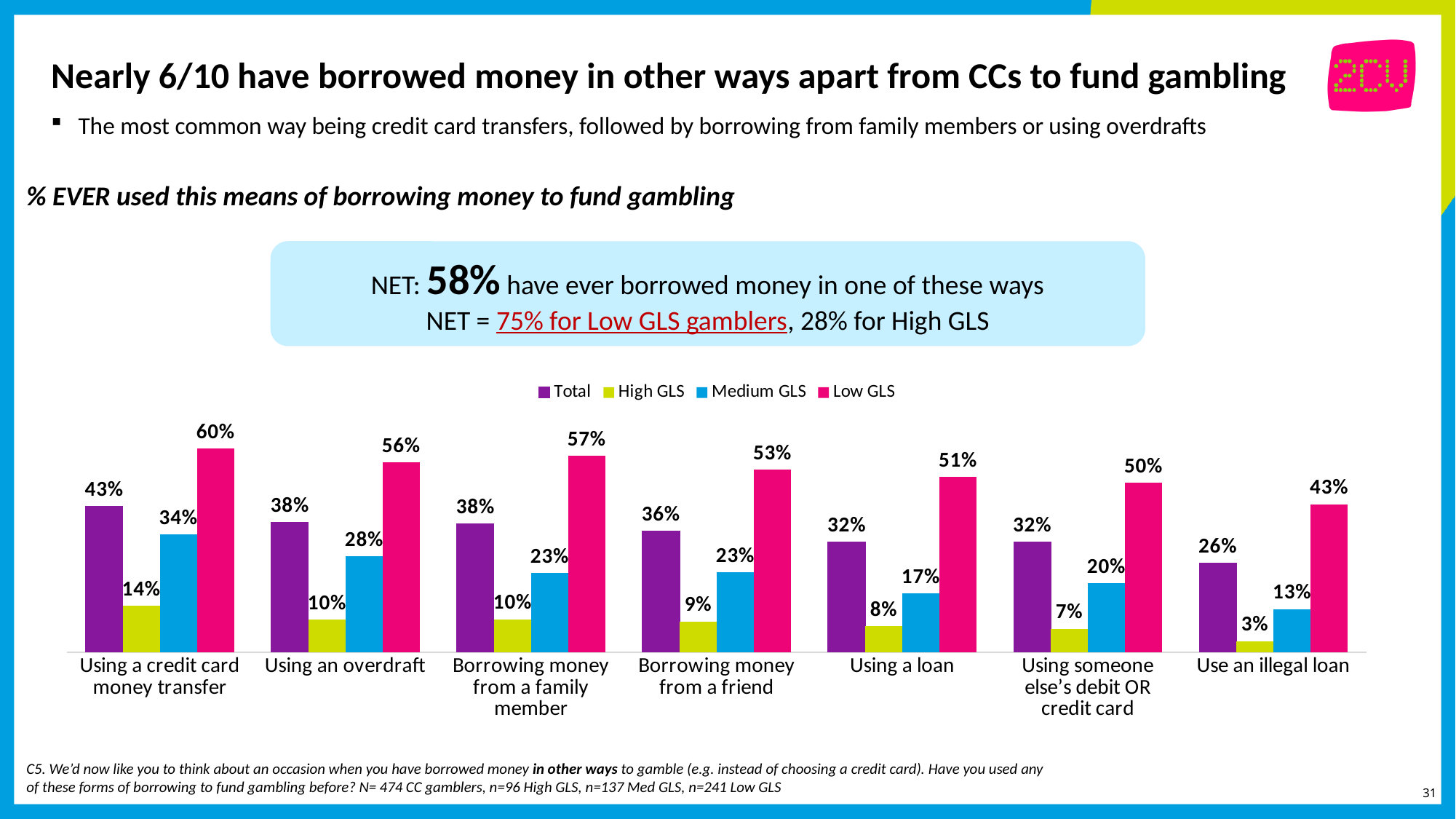
What is the difference between the Low GLS and High GLS values for 'Using an overdraft'? 46 percentage points Which category has the lowest Total value? Use an illegal loan What is the Total value for 'Using a credit card money transfer'? 43% Which series is shown in pink in the chart? Low GLS Which is larger: the Medium GLS value for 'Using a credit card money transfer' or the Medium GLS value for 'Using an overdraft'? Using a credit card money transfer What is the High GLS value for 'Use an illegal loan'? 3% Which category has the highest Low GLS value? Using a credit card money transfer How many categories are shown on the x axis of the chart? 7 How many series does the chart legend list? 4 What is the Medium GLS value for 'Using a loan'? 17% What type of chart is shown on the slide? Bar chart What is the Low GLS value for 'Borrowing money from a family member'? 57%